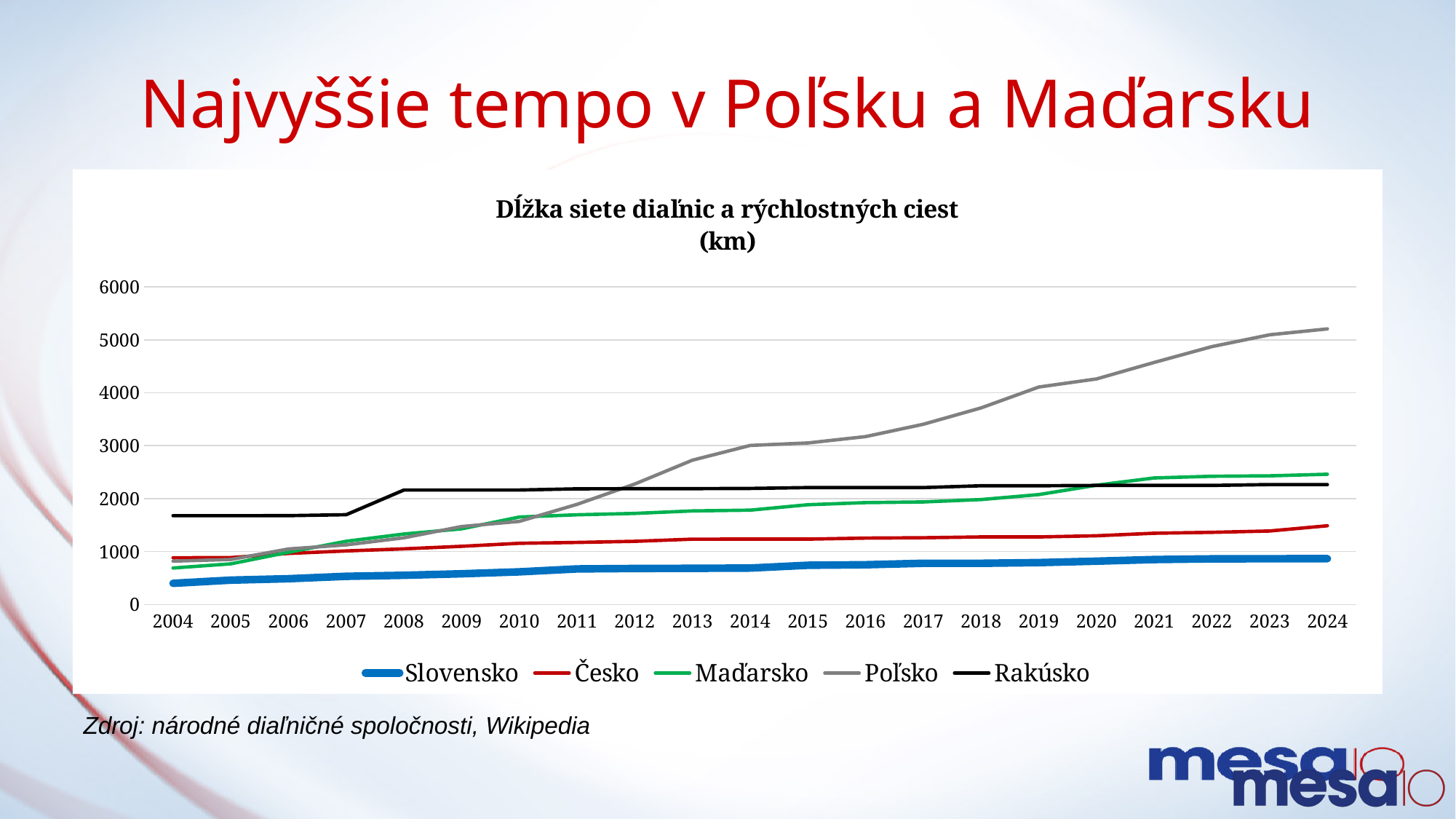
Is the value for Slovensko in 2004 greater or less than 1000? less Is the value for Maďarsko in 2024 greater or less than 2000? greater Which country has the highest value in 2024? Poľsko Which is larger in 2010, the value for Poľsko or the value for Rakúsko? Rakúsko Which country has the lowest value in 2024? Slovensko Is the value for Poľsko in 2024 greater or less than 5000? greater Does the value for Poľsko rise or fall from 2004 to 2024? rise How many years are shown on the x axis? 21 How many series does the legend list? 5 What is the title of the chart? Dĺžka siete diaľnic a rýchlostných ciest (km) What kind of chart is shown on the slide? line chart